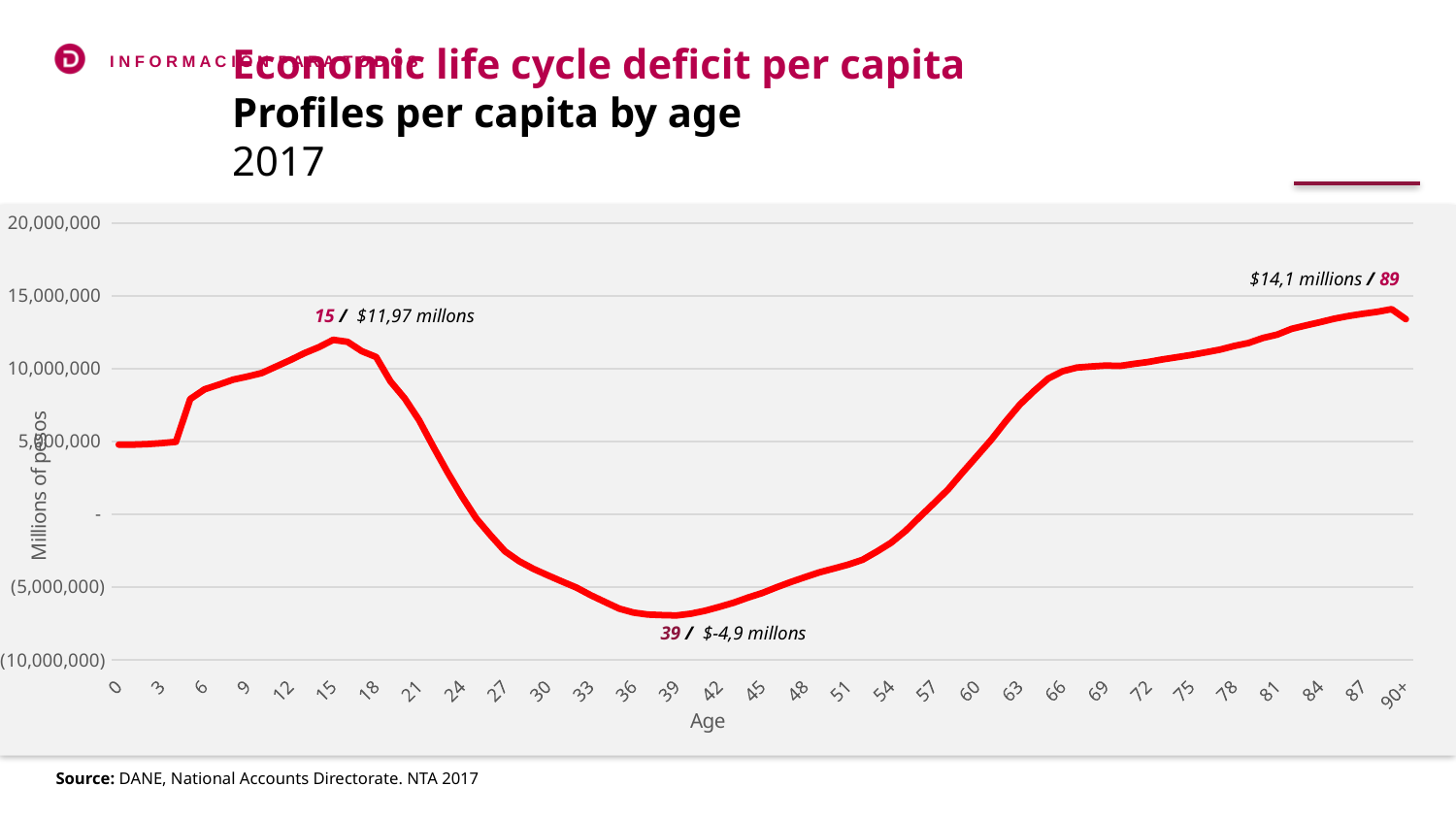
What kind of chart is shown on the slide? line chart Is the value at age 30 greater or less than (5,000,000)? greater Is the value at age 66 greater or less than 5,000,000? greater What is the economic life cycle deficit per capita labelled at age 15? $11,97 millons At which labelled age does the line reach its lowest value? 39 Which labelled age has the higher value, 15 or 89? 89 What is the title of the vertical axis? Millions of pesos What is the economic life cycle deficit per capita labelled at age 89? $14,1 millions Do the values rise or fall along the x axis between age 15 and age 39? fall What is the economic life cycle deficit per capita labelled at age 39? $-4,9 millons Is the value at age 0 greater or less than 10,000,000? less At which labelled age does the line reach its highest value? 89